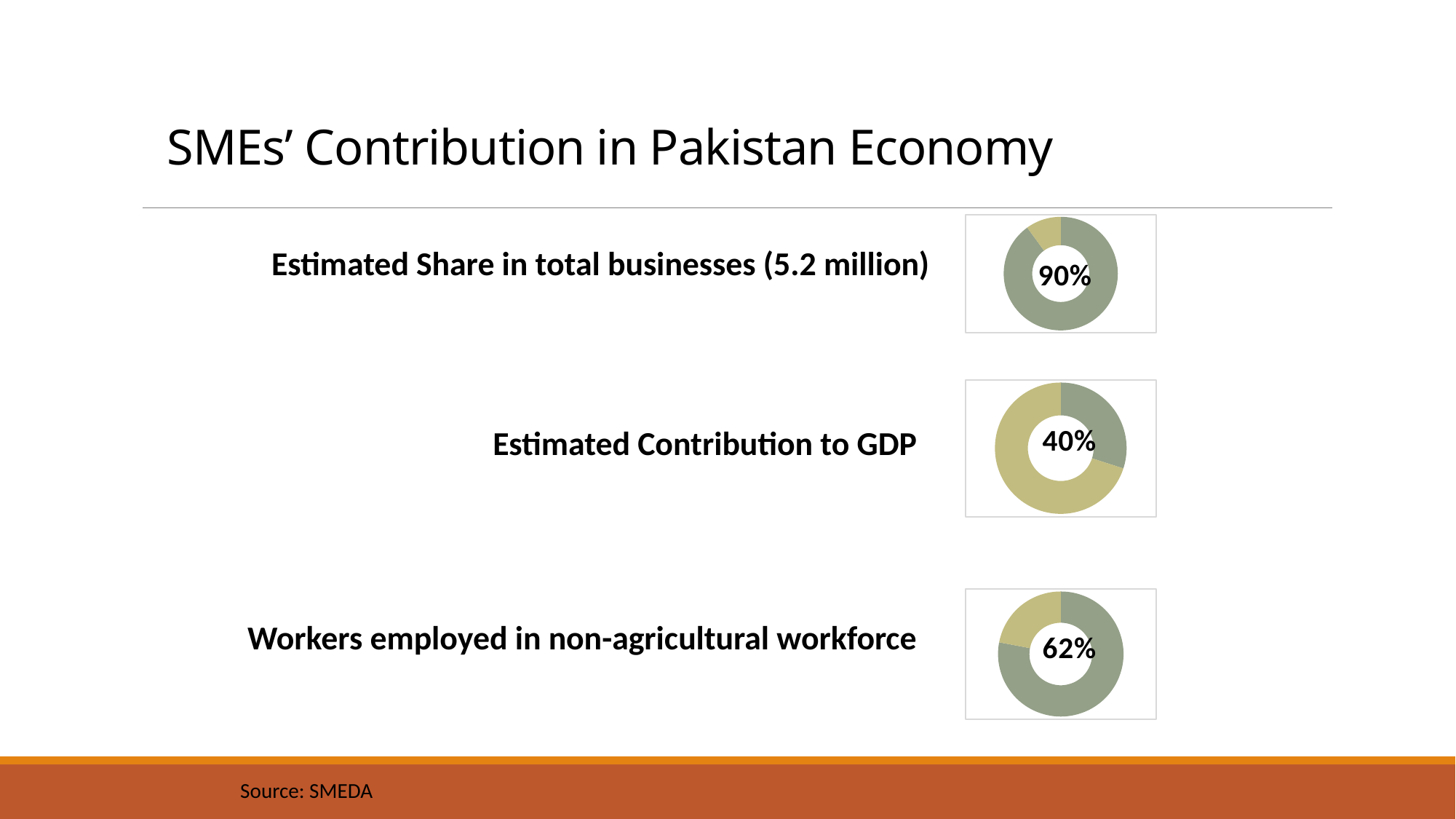
What kind of chart is used for each of the three figures on the slide? Doughnut chart In the middle chart next to 'Estimated Contribution to GDP', what percentage is shown? 40% In the top chart next to 'Estimated Share in total businesses (5.2 million)', what percentage is shown in the centre of the doughnut? 90% How many slices does each doughnut chart on the slide contain? 2 What is the difference in percentage points between the top chart (Estimated Share in total businesses) and the middle chart (Estimated Contribution to GDP)? 50 percentage points Which of the three measures on the slide has the highest percentage? Estimated Share in total businesses (5.2 million) What source is cited at the bottom of the slide for the chart data? SMEDA How many doughnut charts are shown on the slide? 3 Which of the three measures on the slide has the lowest percentage? Estimated Contribution to GDP In the bottom chart next to 'Workers employed in non-agricultural workforce', what percentage is shown? 62% Which is larger: the percentage in the middle chart (Estimated Contribution to GDP) or the bottom chart (Workers employed in non-agricultural workforce)? Workers employed in non-agricultural workforce In the top chart (Estimated Share in total businesses), what share of the doughnut does the lighter, unlabelled slice represent? 10%